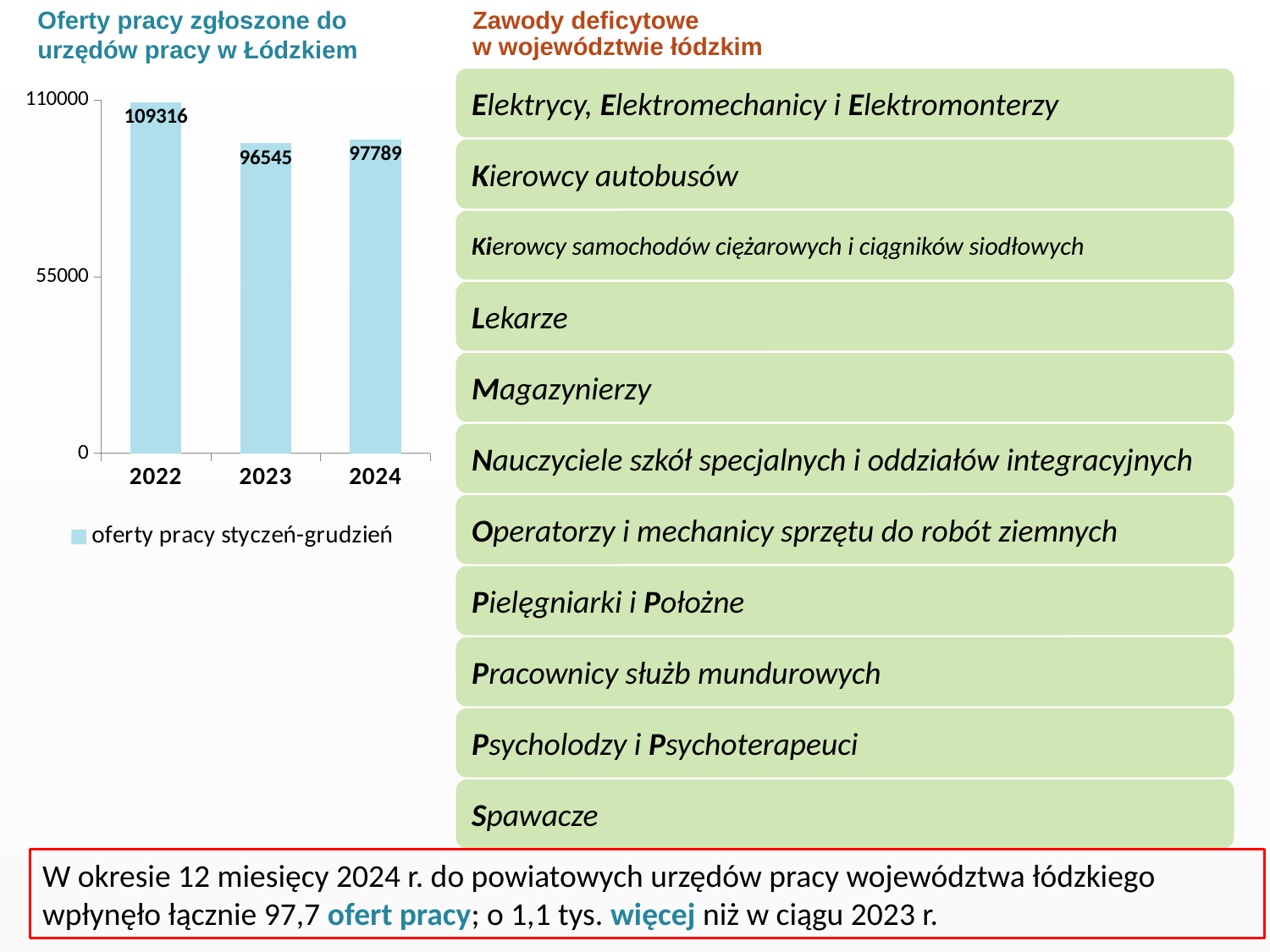
What kind of chart is shown on the slide? bar chart What is the value for 2022 in the chart 'Oferty pracy zgłoszone do urzędów pracy w Łódzkiem'? 109316 Which is larger, the value for 2023 or the value for 2024? 2024 What is the value for 2024 in the chart? 97789 Is the value for 2023 greater or less than 55000? greater Which year has the lowest number of job offers in the chart? 2023 What is the value for 2023 in the chart? 96545 How many years are shown on the x axis of the chart? 3 Which year has the highest number of job offers in the chart? 2022 What is the difference between the values for 2024 and 2023? 1244 What is the legend entry of the chart? oferty pracy styczeń-grudzień What is the difference between the values for 2022 and 2023? 12771